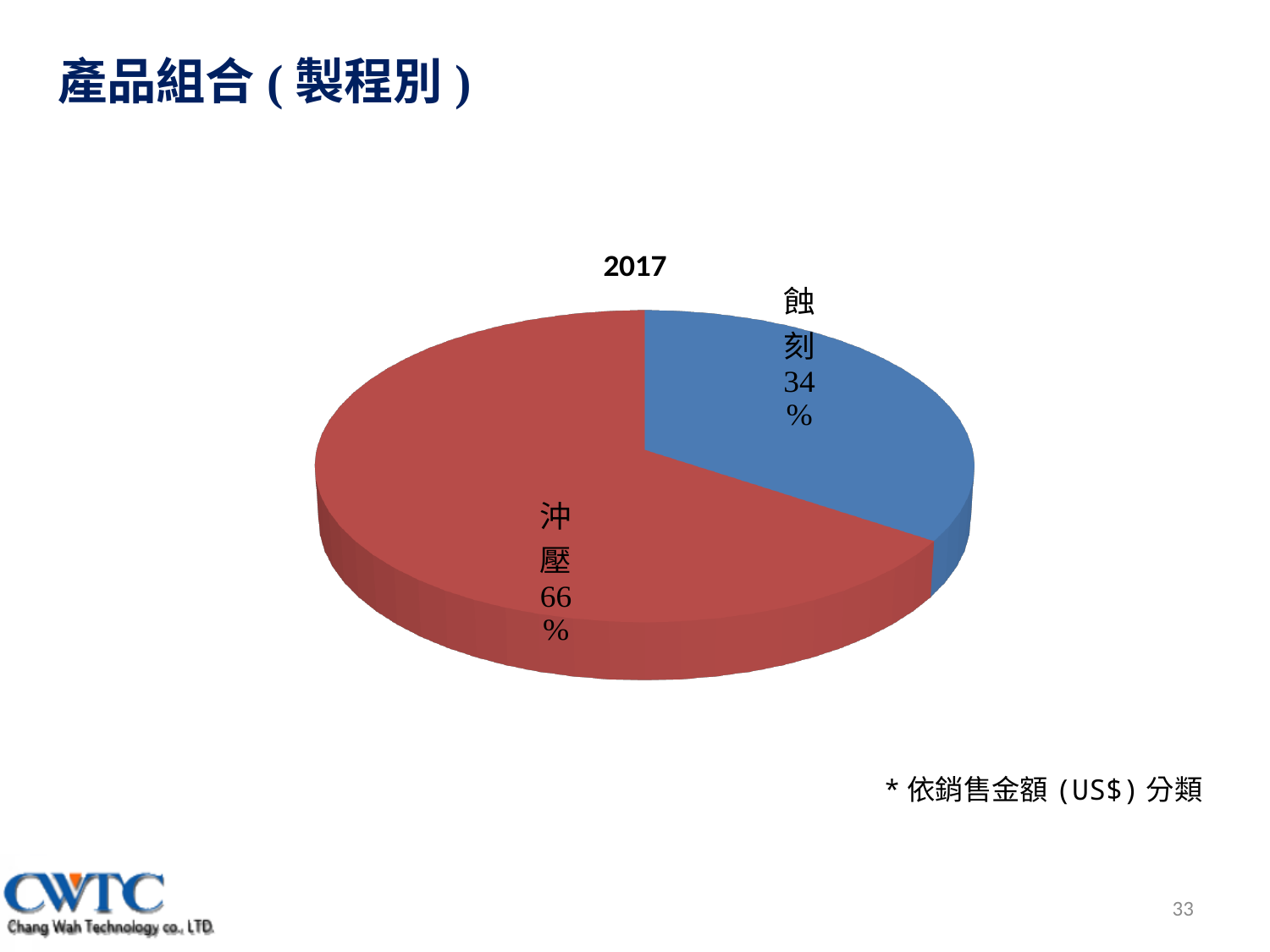
How many slices does the pie chart have? 2 Which category has the largest share of the pie? 沖壓 What is the title of the chart? 2017 What kind of chart is shown on the slide? pie chart Which category has the smallest share of the pie? 蝕刻 What is the difference in percentage points between the 沖壓 and 蝕刻 shares? 32 Which is larger, the share for 沖壓 or the share for 蝕刻? 沖壓 What share of the pie does 沖壓 have? 66% What share of the pie does 蝕刻 have? 34% What colour is the 蝕刻 slice? blue